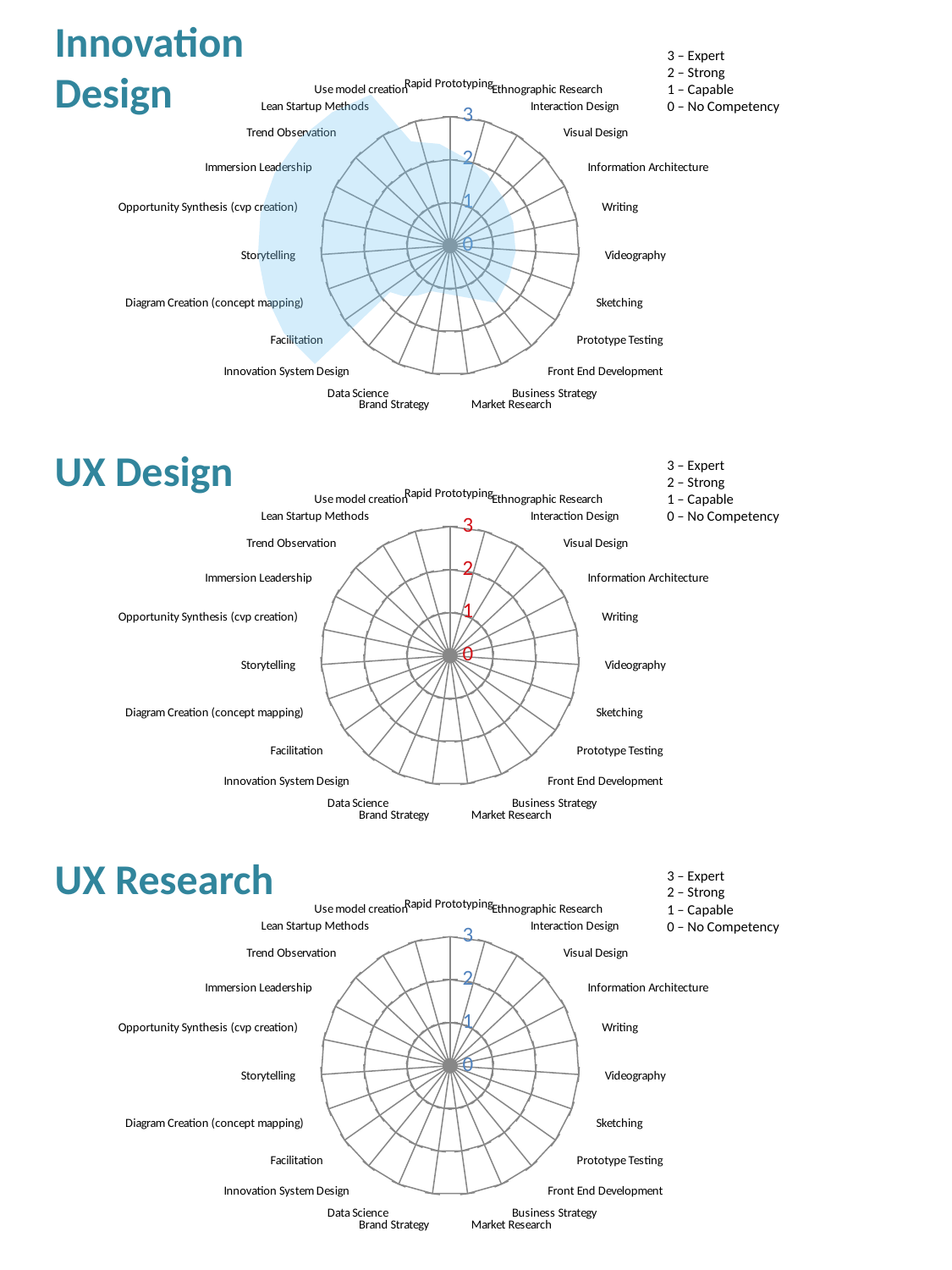
How many competency categories are plotted around the Innovation Design radar chart? 23 On the Innovation Design chart, is the value for Front End Development greater or less than 2? less On the Innovation Design chart, is the value for Writing greater or less than 2? less What kind of chart is the Innovation Design chart? radar chart What is the highest tick value shown on the scale of the UX Research radar chart? 3 On the Innovation Design chart, is the value for Use model creation greater or less than 2? greater According to the key next to the UX Design chart, what competency level does a value of 3 represent? Expert On the Innovation Design chart, which is larger, the value for Storytelling or the value for Business Strategy? Storytelling